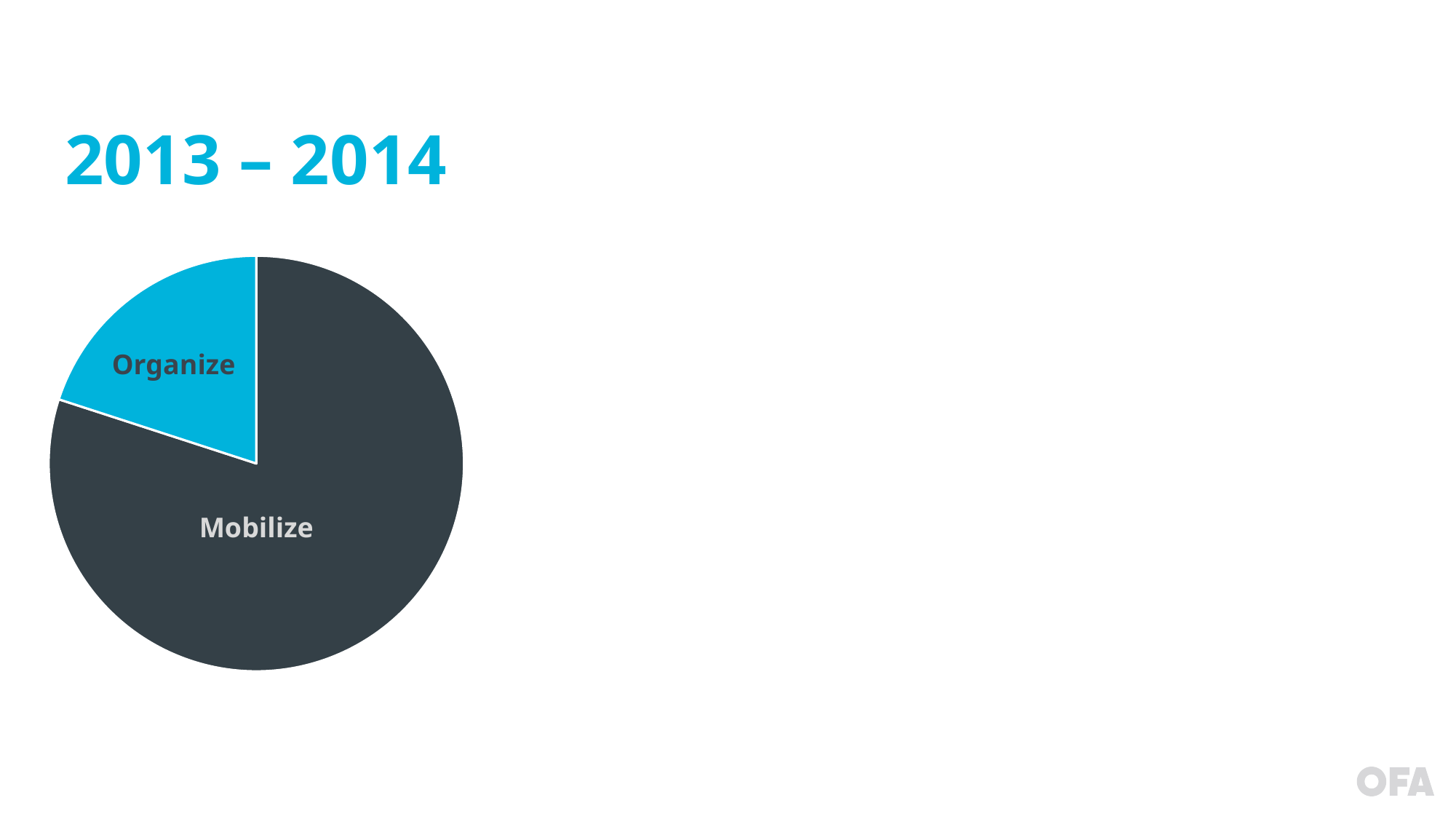
Which slice of the pie chart is the largest? Mobilize What is the title shown above the pie chart? 2013 – 2014 How many slices does the pie chart have? 2 Which slice is larger, Organize or Mobilize? Mobilize What kind of chart is shown on the slide? pie chart Which slice of the pie chart is the smallest? Organize What colour is the Organize slice of the pie chart? light blue